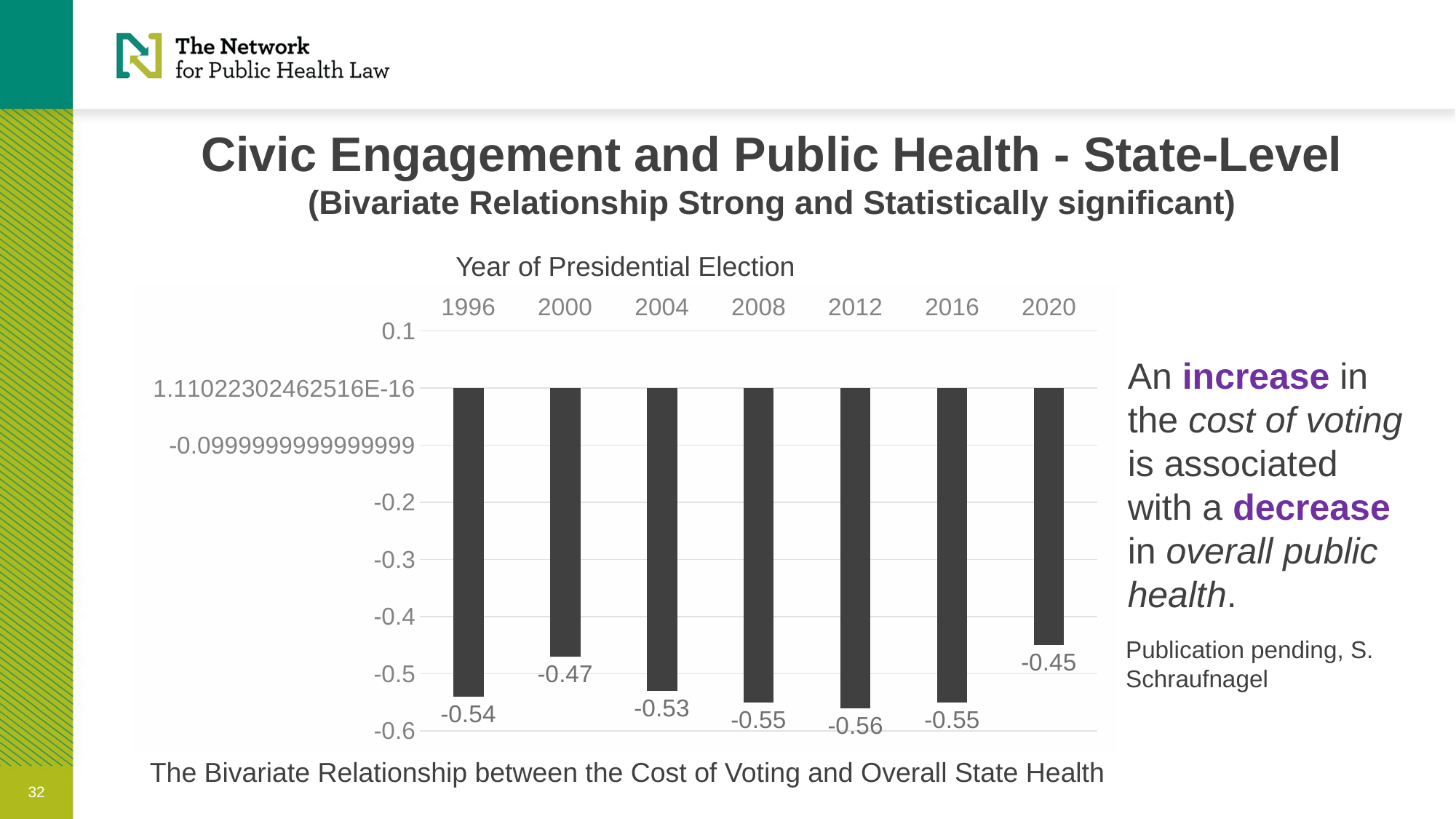
What is the difference between the values for 2000 and 2020? 0.02 What is the value for 1996? -0.54 What is the value for 2000? -0.47 What kind of chart is shown on the slide? Bar chart What is the value for 2012? -0.56 What is the caption below the chart? The Bivariate Relationship between the Cost of Voting and Overall State Health Which is larger, the value for 2004 or the value for 2008? 2004 Which year has the lowest (most negative) value? 2012 Which year has the highest (least negative) value? 2020 What is the value for 2020? -0.45 How many presidential election years are shown on the x axis? 7 Is the value for 2000 greater or less than -0.5? greater